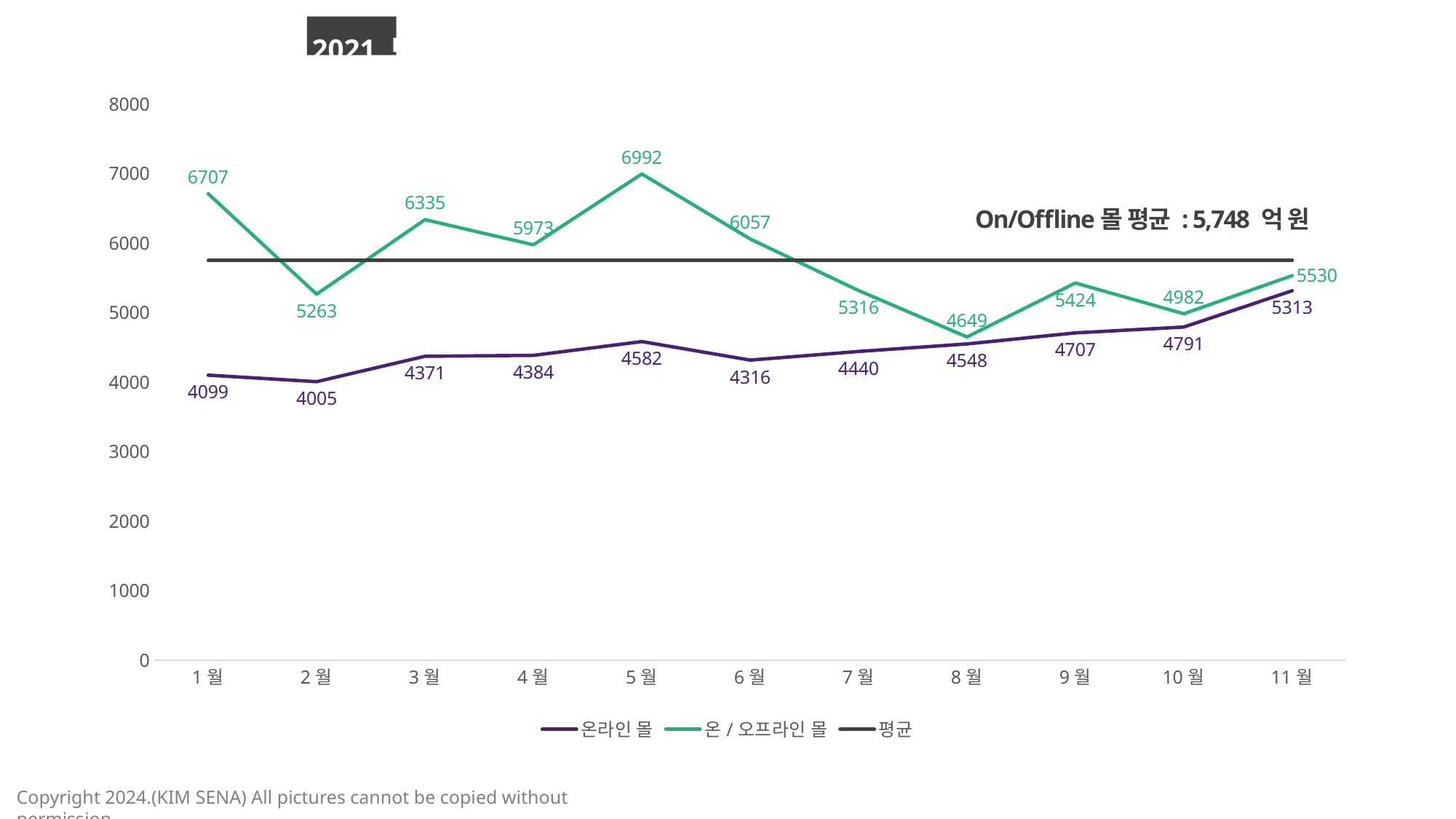
What average value is stated for On/Offline 몰 on the slide? 5,748 억 원 What is the value for 온라인 몰 in 5 월? 4582 In which month does 온 / 오프라인 몰 reach its highest value? 5 월 What is the difference between 온 / 오프라인 몰 and 온라인 몰 in 1 월? 2608 How many months are shown on the x axis? 11 Is the 온 / 오프라인 몰 value in 10 월 greater or less than 5000? less In which month is the 온라인 몰 value lowest? 2 월 What is the value for 온 / 오프라인 몰 in 2 월? 5263 Which is larger in 8 월: 온라인 몰 or 온 / 오프라인 몰? 온 / 오프라인 몰 How many series does the legend list? 3 Does the 온라인 몰 line rise or fall from 8 월 to 11 월? rise What kind of chart is shown on the slide? line chart